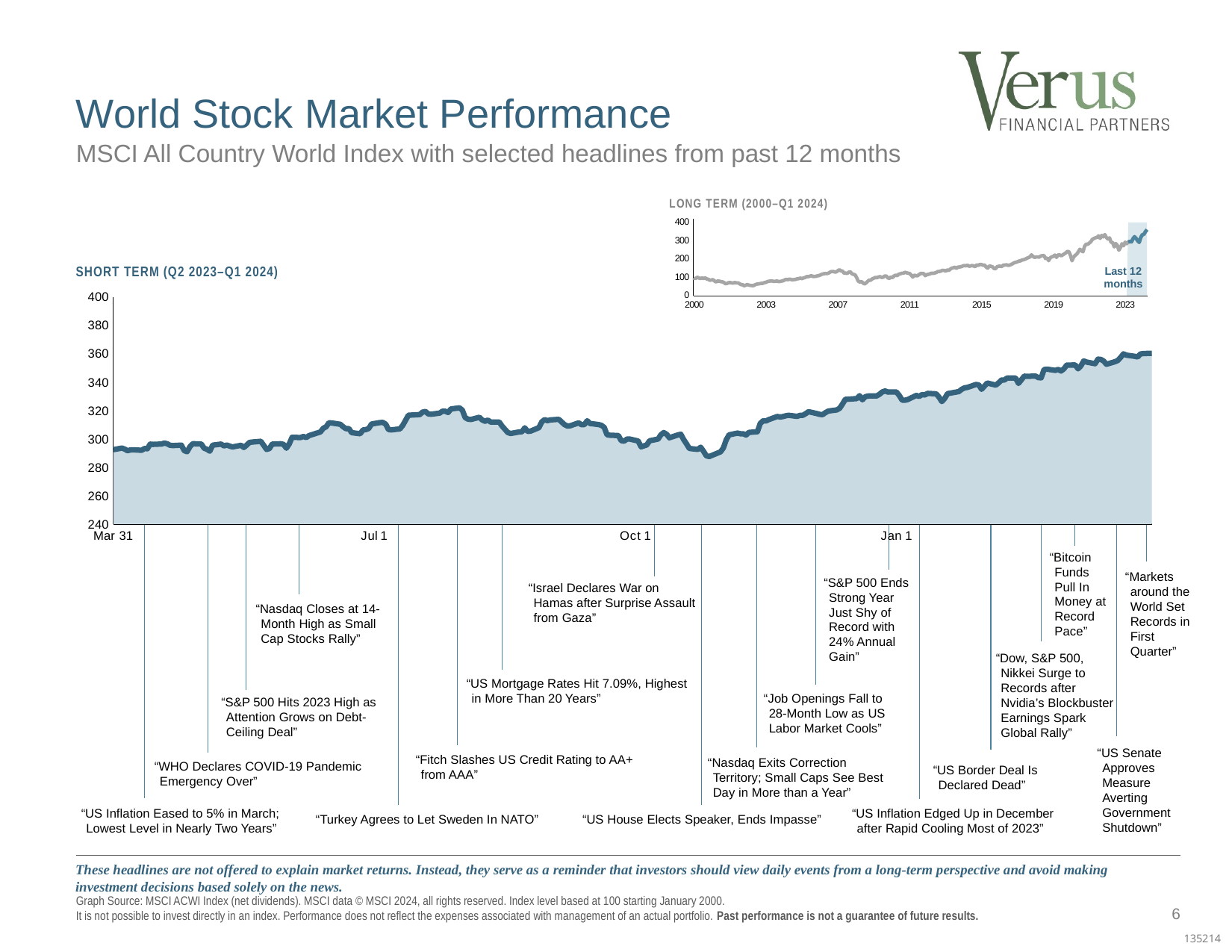
On the SHORT TERM chart, is the index level at Jan 1 greater or less than 320? greater On the LONG TERM chart, does the index level rise or fall overall from 2000 to Q1 2024? rise On the LONG TERM (2000–Q1 2024) chart, what is the index level at the start in 2000? 100 What label is given to the shaded region at the right end of the LONG TERM chart? Last 12 months On the LONG TERM chart, is the index level at the end of the period (2023–Q1 2024) greater or less than 300? greater On the SHORT TERM chart, is the index level at Oct 1 greater or less than 320? less How many date labels appear on the horizontal axis of the SHORT TERM chart? 4 What kind of chart is the SHORT TERM (Q2 2023–Q1 2024) chart? area chart On the SHORT TERM chart, does the index level rise or fall overall from Mar 31 to the end of the period? rise On the SHORT TERM chart, what is the highest value shown on the vertical axis? 400